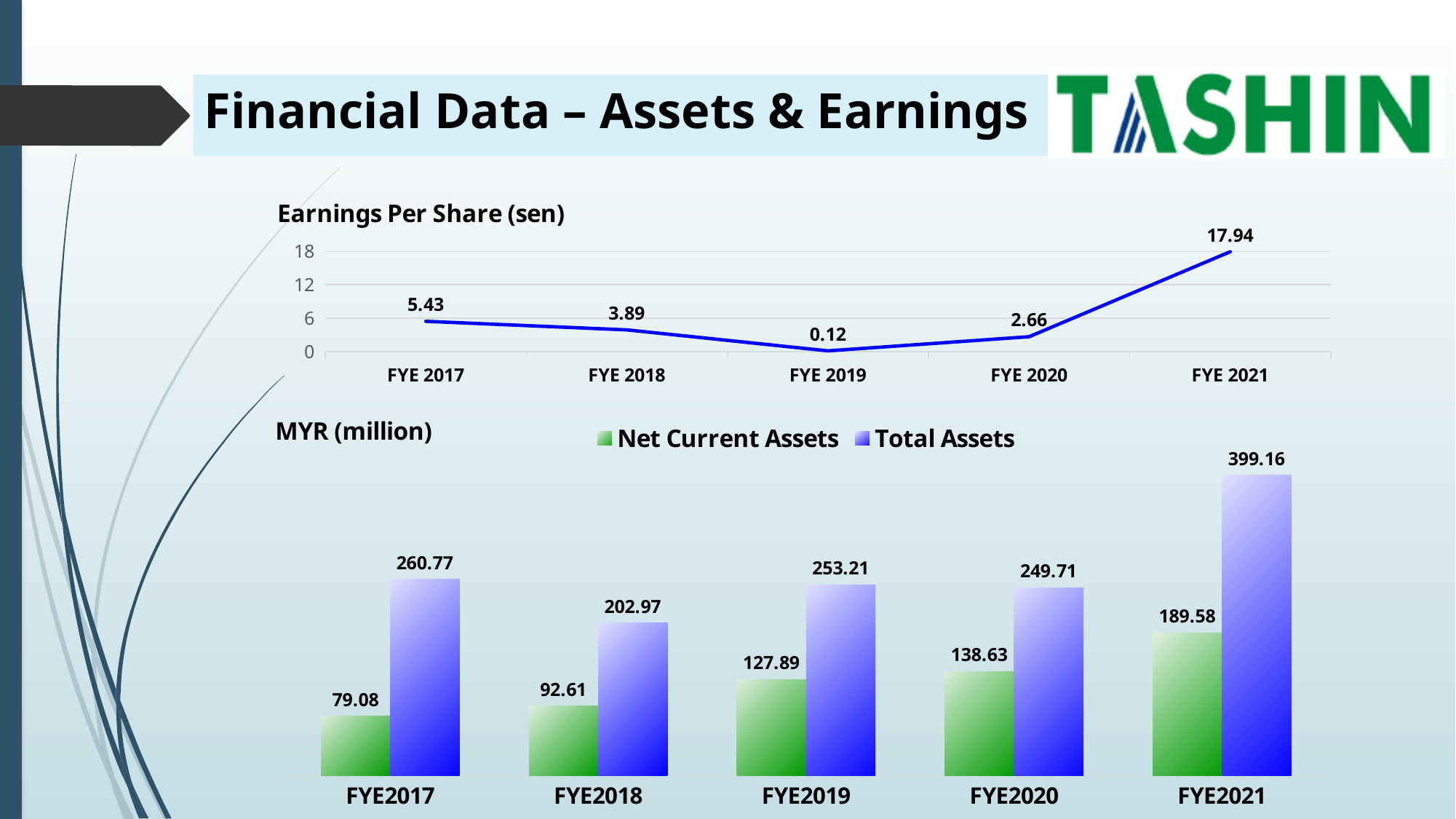
In the Earnings Per Share (sen) chart, what is the difference between FYE 2021 and FYE 2020? 15.28 In the Earnings Per Share (sen) chart, what kind of chart is shown? Line chart In the MYR (million) bar chart, what is the Total Assets value for FYE2019? 253.21 In the Earnings Per Share (sen) chart, which year has the highest earnings per share? FYE 2021 In the Earnings Per Share (sen) chart, which year has the lowest earnings per share? FYE 2019 In the MYR (million) bar chart, do Net Current Assets rise or fall from FYE2017 to FYE2021? Rise In the MYR (million) bar chart, what is the Net Current Assets value for FYE2021? 189.58 In the MYR (million) bar chart, which year has the highest Total Assets? FYE2021 In the Earnings Per Share (sen) chart, how many years are plotted? 5 In the MYR (million) bar chart, what is the difference between Total Assets and Net Current Assets for FYE2017? 181.69 In the Earnings Per Share (sen) chart, what is the value for FYE 2019? 0.12 In the MYR (million) bar chart, how many series does the legend list? 2